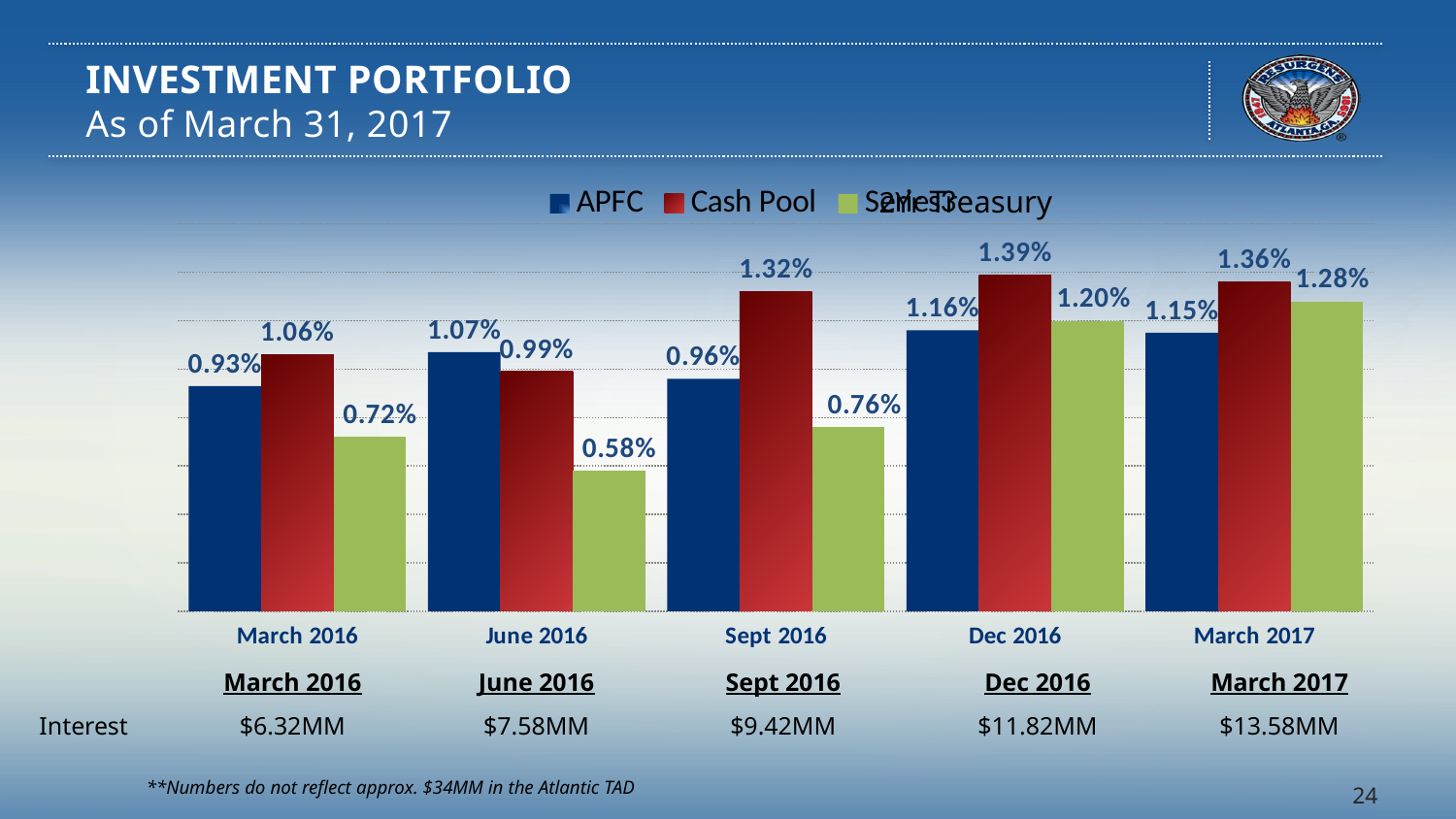
What is the first series listed in the chart legend? APFC What is the difference between the Cash Pool and APFC values for Sept 2016? 0.36% In which period is the APFC value lowest? March 2016 What is the value of the light green bar for Dec 2016? 1.20% What kind of chart is shown on the slide? bar chart Which is larger for June 2016, APFC or Cash Pool? APFC How many periods are shown on the x axis of the chart? 5 What is the APFC value for March 2016? 0.93% In which period is the Cash Pool value highest? Dec 2016 What is the Cash Pool value for Sept 2016? 1.32% How many series does the chart legend list? 3 Does the Cash Pool value rise or fall from June 2016 to Sept 2016? rise